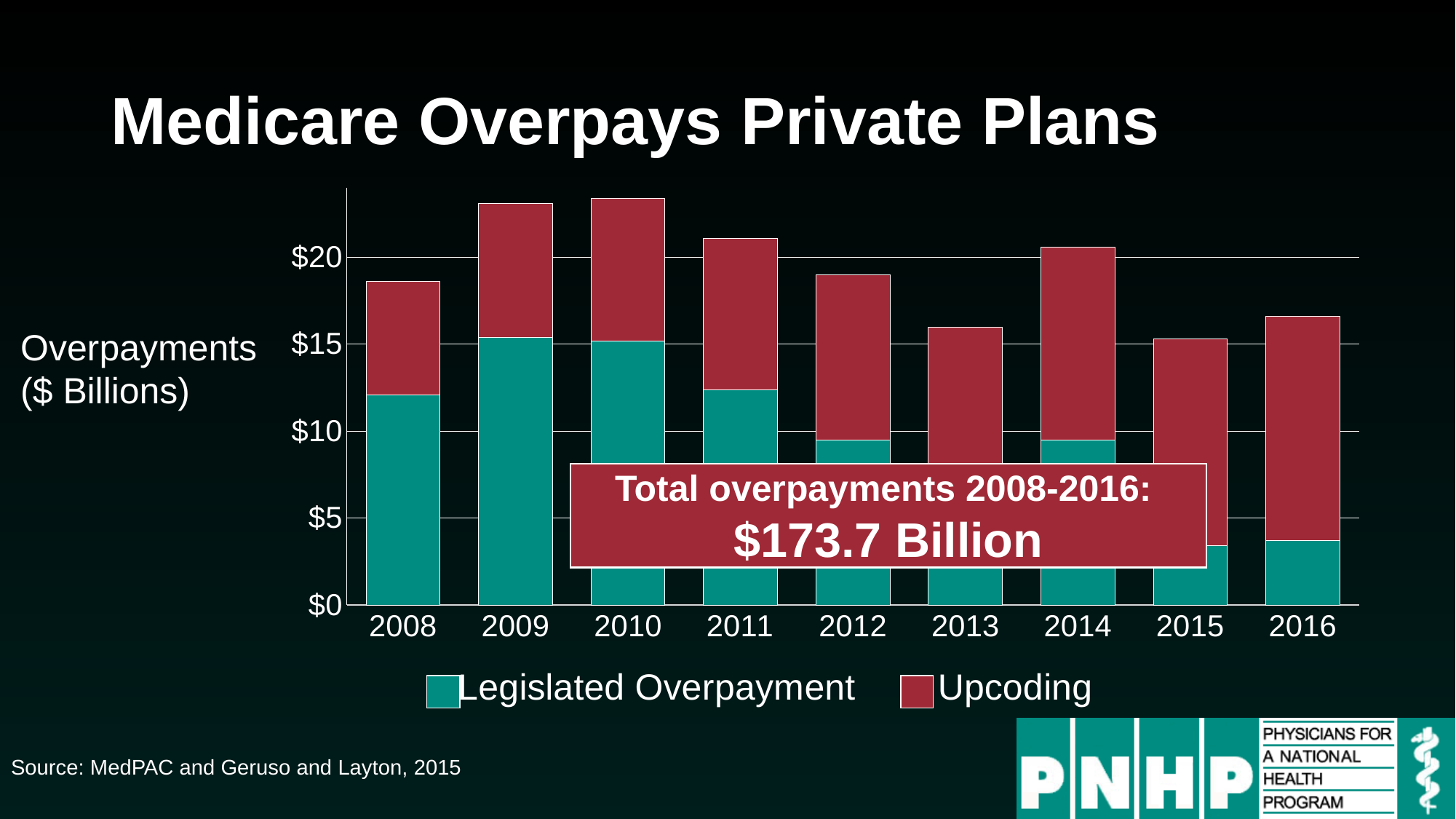
How many years are shown along the x axis of the chart? 9 Which year has the largest Upcoding segment? 2016 What are the two series named in the chart's legend? Legislated Overpayment and Upcoding Is the Legislated Overpayment value for 2016 greater or less than $5 billion? less Does the Legislated Overpayment generally rise or fall from 2008 to 2016? fall How many series does the chart's legend list? 2 Is the Legislated Overpayment value for 2011 greater or less than $10 billion? greater Is the total overpayment for 2008 greater or less than $20 billion? less What kind of chart is shown on the slide? Stacked bar chart What total overpayment figure for 2008-2016 is printed on the chart? $173.7 Billion Which is larger, the Legislated Overpayment for 2008 or for 2012? 2008